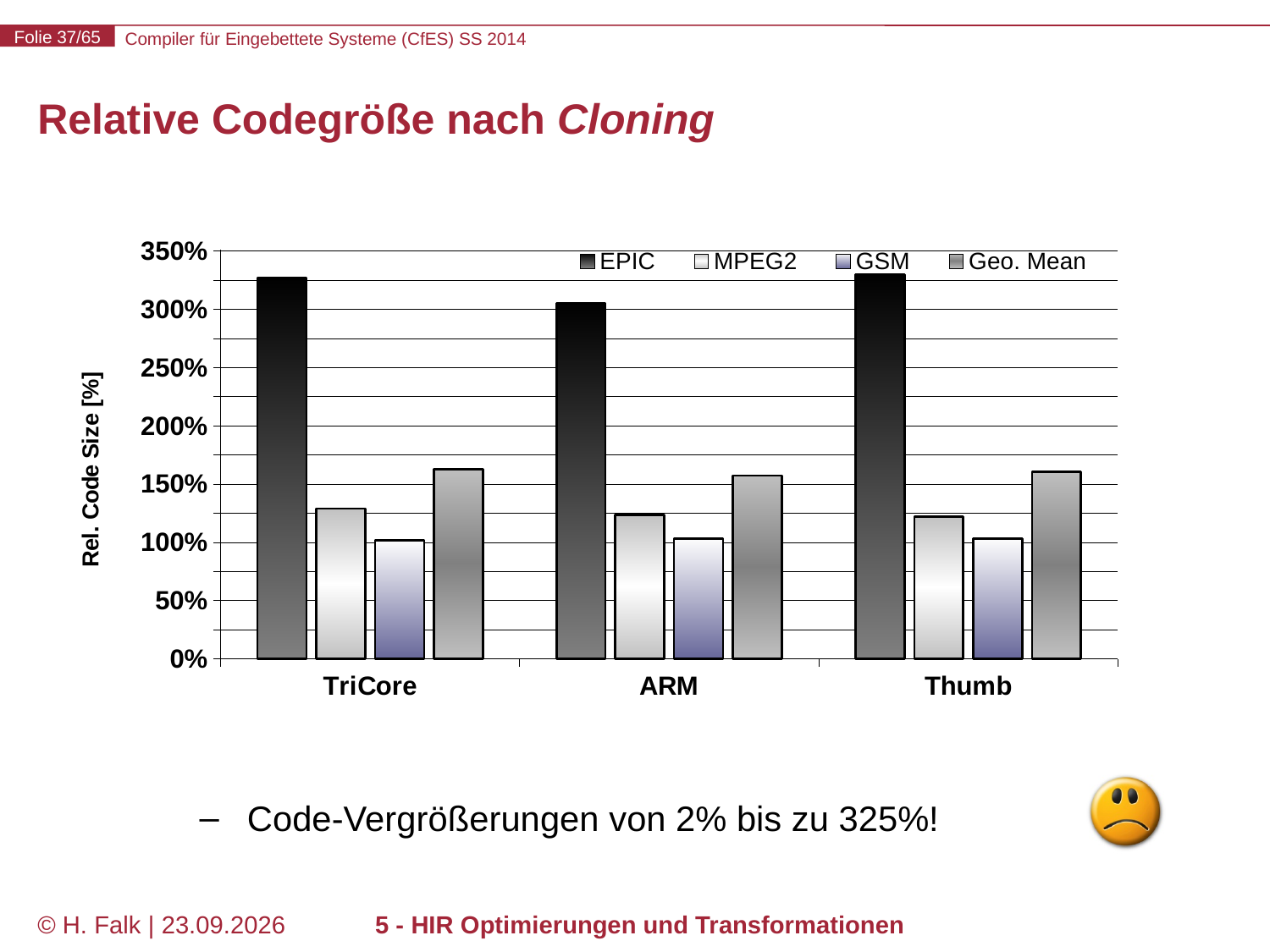
Is the EPIC value for TriCore greater or less than 300%? greater Which series has the lowest value for ARM? GSM How many categories are shown on the x axis of the chart? 3 What kind of chart is shown on the slide? bar chart Is the EPIC value for Thumb greater or less than 300%? greater Which series has the highest value for TriCore? EPIC Is the GSM value for Thumb greater or less than 150%? less How many series does the chart's legend list? 4 What is the label of the chart's vertical axis? Rel. Code Size [%] Which is larger for TriCore: the MPEG2 value or the Geo. Mean value? Geo. Mean Which is larger: the EPIC value for ARM or the EPIC value for Thumb? Thumb